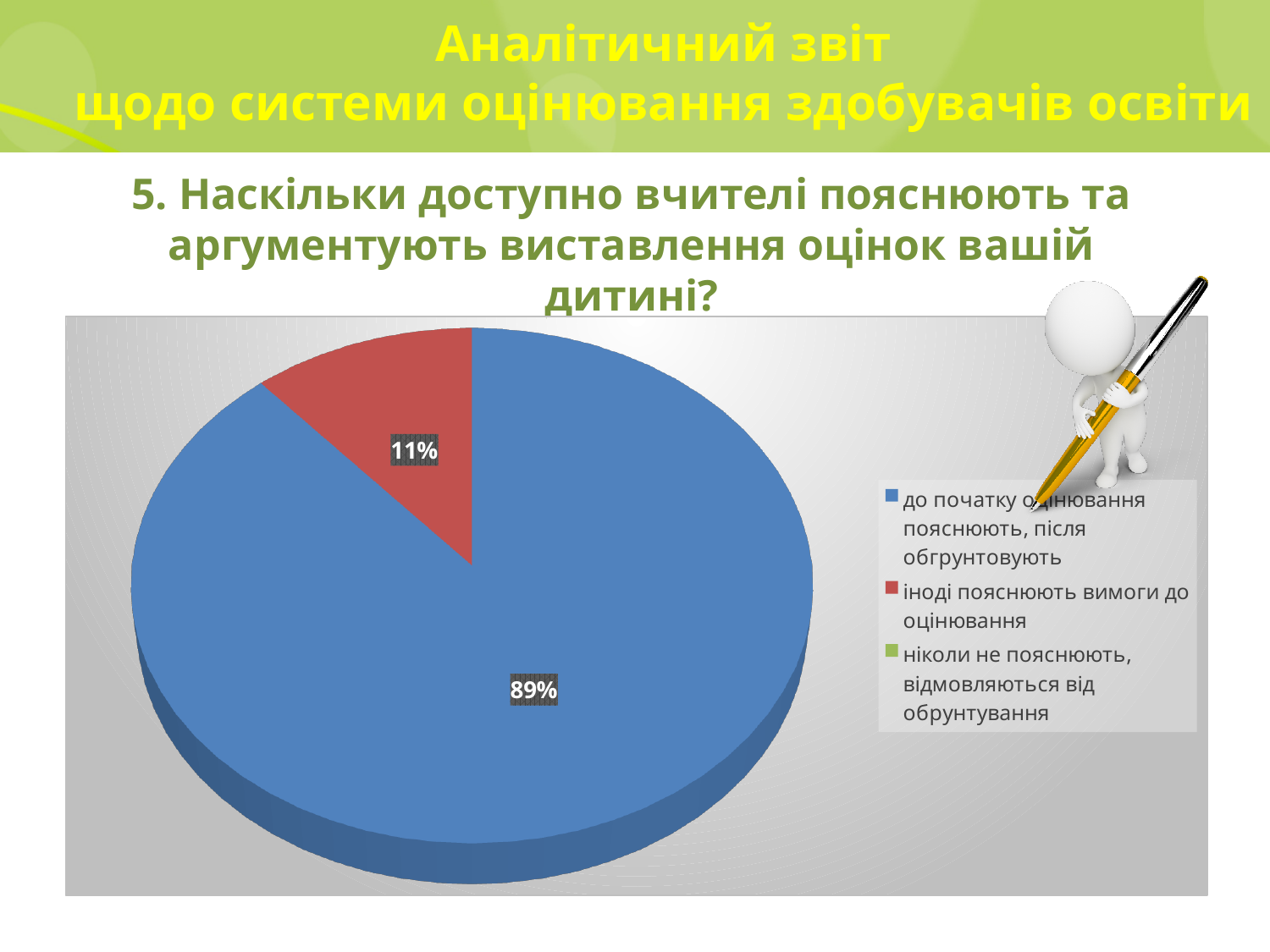
What percentage is shown for the slice 'іноді пояснюють вимоги до оцінювання'? 11% Which legend entry is shown in green? ніколи не пояснюють, відмовляються від обрунтування What percentage is shown for the slice 'до початку оцінювання пояснюють, після обгрунтовують'? 89% What is the difference in percentage points between the 89% slice and the 11% slice? 78 How many slices with data labels are visible in the pie? 2 What kind of chart is shown on the slide? pie chart What colour is the largest slice of the pie? blue Which category has the largest slice of the pie? до початку оцінювання пояснюють, після обгрунтовують What share of the pie does the blue slice represent? 89% Which is larger: the slice for 'іноді пояснюють вимоги до оцінювання' or the slice for 'до початку оцінювання пояснюють, після обгрунтовують'? до початку оцінювання пояснюють, після обгрунтовують How many entries does the legend list? 3 What share of the pie does the red slice represent? 11%